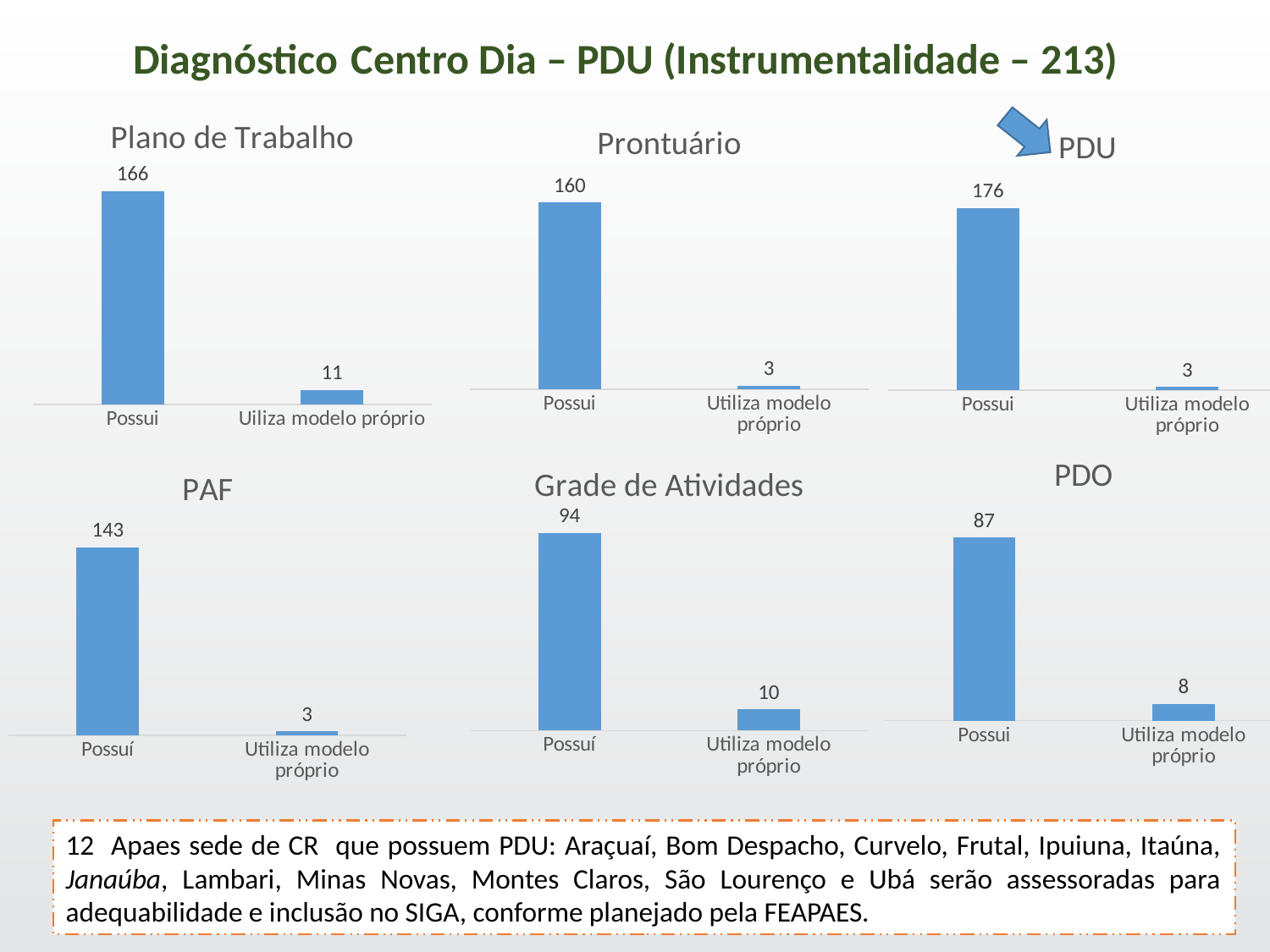
In the 'Grade de Atividades' chart, which category has the lowest value? Utiliza modelo próprio How many categories does the 'PAF' chart show? 2 In the 'PDU' chart, what is the value for 'Possui'? 176 What type of chart is the 'Prontuário' chart? Bar chart In the 'Grade de Atividades' chart, what is the value for 'Utiliza modelo próprio'? 10 In the 'PAF' chart, what is the value for 'Possuí'? 143 In the 'PDO' chart, what is the value for 'Utiliza modelo próprio'? 8 In the 'Prontuário' chart, what is the value for 'Utiliza modelo próprio'? 3 In the 'Plano de Trabalho' chart, what is the difference between 'Possui' and 'Uiliza modelo próprio'? 155 In the 'PDO' chart, which category has the highest value? Possui Which is larger: 'Possui' in the 'PDU' chart or 'Possui' in the 'Prontuário' chart? PDU In the 'Plano de Trabalho' chart, what is the value for 'Possui'? 166